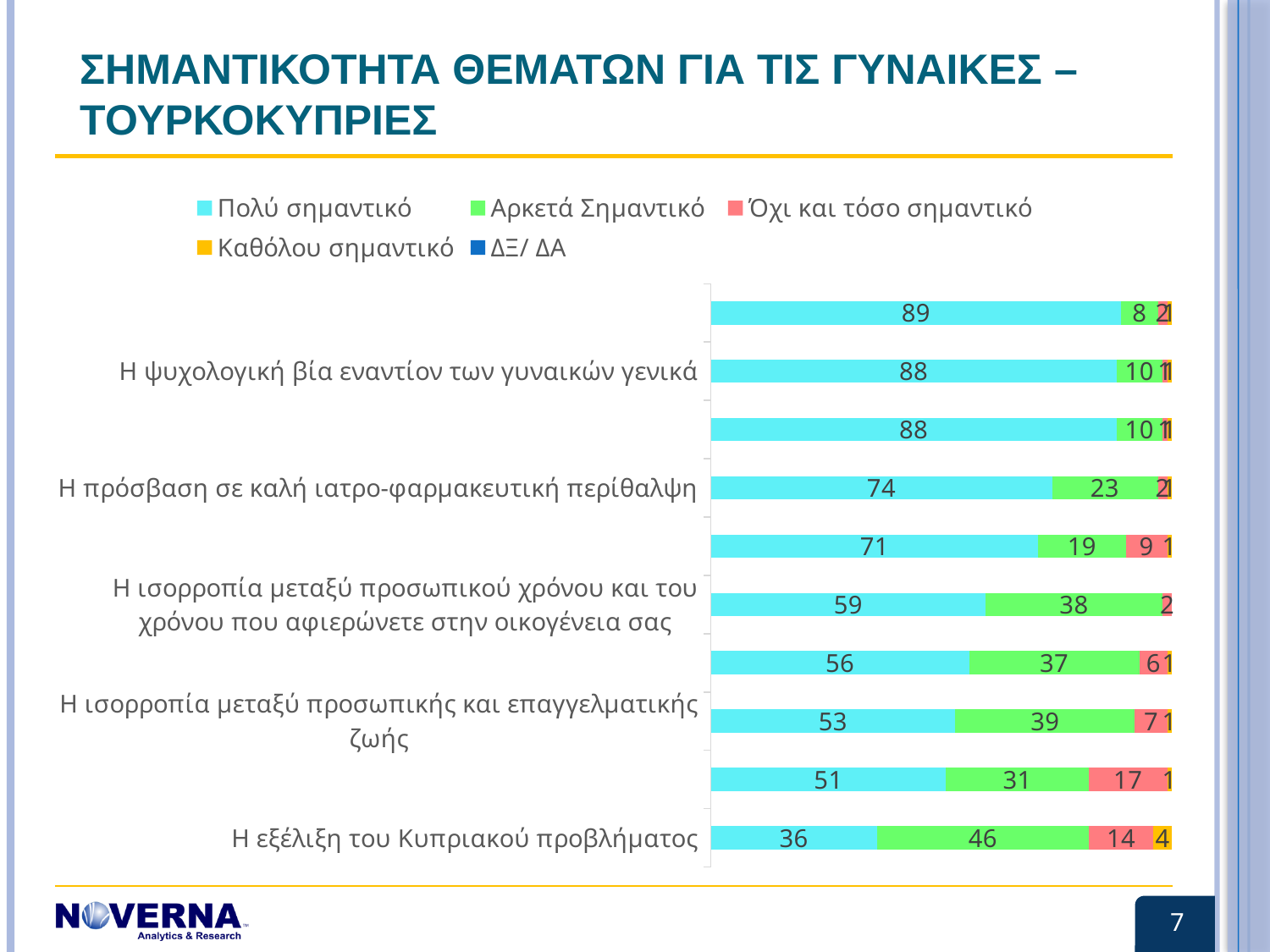
What is the 'Αρκετά Σημαντικό' value for 'Η πρόσβαση σε καλή ιατρο-φαρμακευτική περίθαλψη'? 23 What is the 'Πολύ σημαντικό' value for 'Η ψυχολογική βία εναντίον των γυναικών γενικά'? 88 How many series does the legend list? 5 What type of chart is shown on the slide? Stacked bar chart What is the 'Όχι και τόσο σημαντικό' value for 'Η εξέλιξη του Κυπριακού προβλήματος'? 14 What is the difference between the 'Πολύ σημαντικό' values for 'Η ψυχολογική βία εναντίον των γυναικών γενικά' and 'Η εξέλιξη του Κυπριακού προβλήματος'? 52 Which has a larger 'Πολύ σημαντικό' value: 'Η πρόσβαση σε καλή ιατρο-φαρμακευτική περίθαλψη' or 'Η ισορροπία μεταξύ προσωπικής και επαγγελματικής ζωής'? Η πρόσβαση σε καλή ιατρο-φαρμακευτική περίθαλψη How many bars are plotted in the chart? 10 Do the 'Πολύ σημαντικό' values increase or decrease going from the top bar to the bottom bar? Decrease Which category has the lowest 'Πολύ σημαντικό' value? Η εξέλιξη του Κυπριακού προβλήματος What is the 'Πολύ σημαντικό' value for 'Η ισορροπία μεταξύ προσωπικού χρόνου και του χρόνου που αφιερώνετε στην οικογένεια σας'? 59 Which category has the highest 'Αρκετά Σημαντικό' value? Η εξέλιξη του Κυπριακού προβλήματος